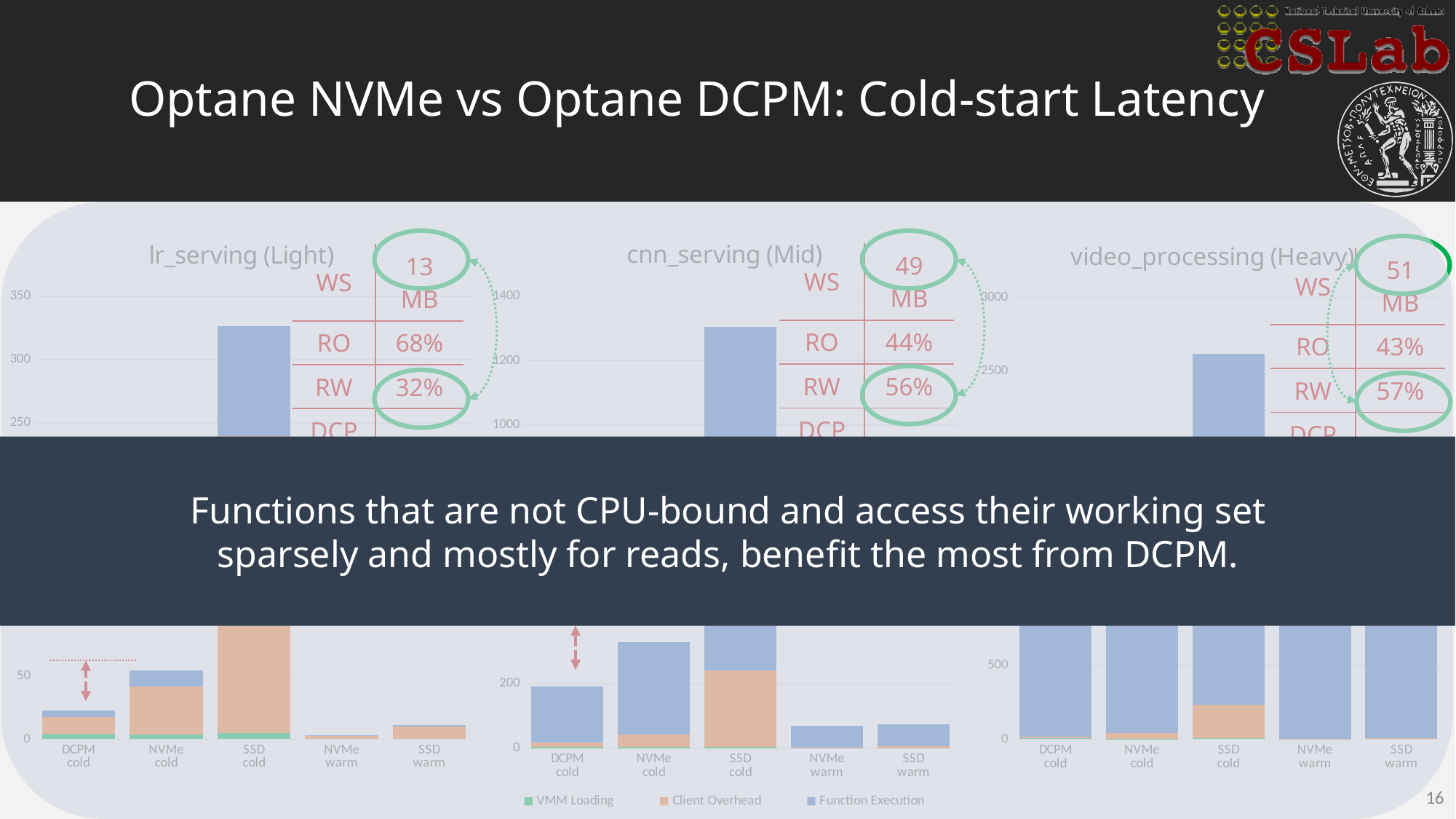
In the lr_serving (Light) chart, which category has the lowest total? NVMe warm In the lr_serving (Light) chart, which is larger, the total for NVMe warm or SSD warm? SSD warm In the lr_serving (Light) chart, is the total for SSD cold greater or less than 50? greater In the lr_serving (Light) chart, is the total for DCPM cold greater or less than 50? less In the cnn_serving (Mid) chart, is the total for NVMe cold greater or less than 200? greater How many series does the legend list for the charts? 3 What are the three legend entries for the charts? VMM Loading, Client Overhead, Function Execution In the cnn_serving (Mid) chart, which is larger, the total for DCPM cold or NVMe cold? NVMe cold What kind of chart is the lr_serving (Light) chart? bar chart How many categories are shown on the x axis of the cnn_serving (Mid) chart? 5